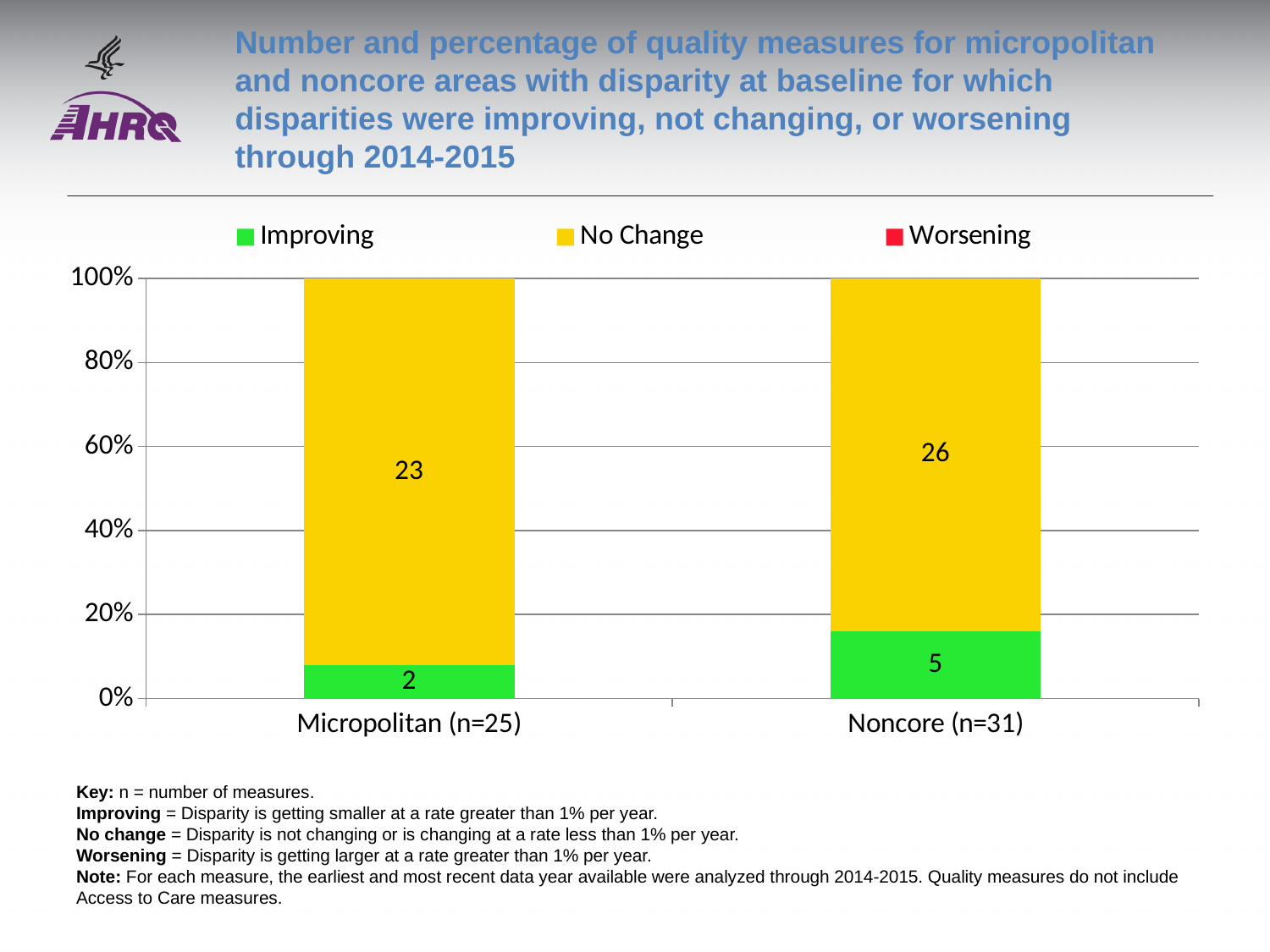
What is the number of No Change measures for Micropolitan (n=25)? 23 How many series does the legend list? 3 What is the total of the labeled values in the Micropolitan (n=25) bar? 25 Is the Improving share of the Noncore (n=31) bar greater or less than 20%? less Is the No Change share of the Micropolitan (n=25) bar greater or less than 80%? greater What is the number of No Change measures for Noncore (n=31)? 26 What is the difference between the No Change counts for Noncore (n=31) and Micropolitan (n=25)? 3 Which category has the higher number of Improving measures, Micropolitan (n=25) or Noncore (n=31)? Noncore (n=31) How many categories are shown on the x axis? 2 What kind of chart is shown on the slide? Stacked bar chart What is the number of Improving measures for Micropolitan (n=25)? 2 What is the number of Improving measures for Noncore (n=31)? 5